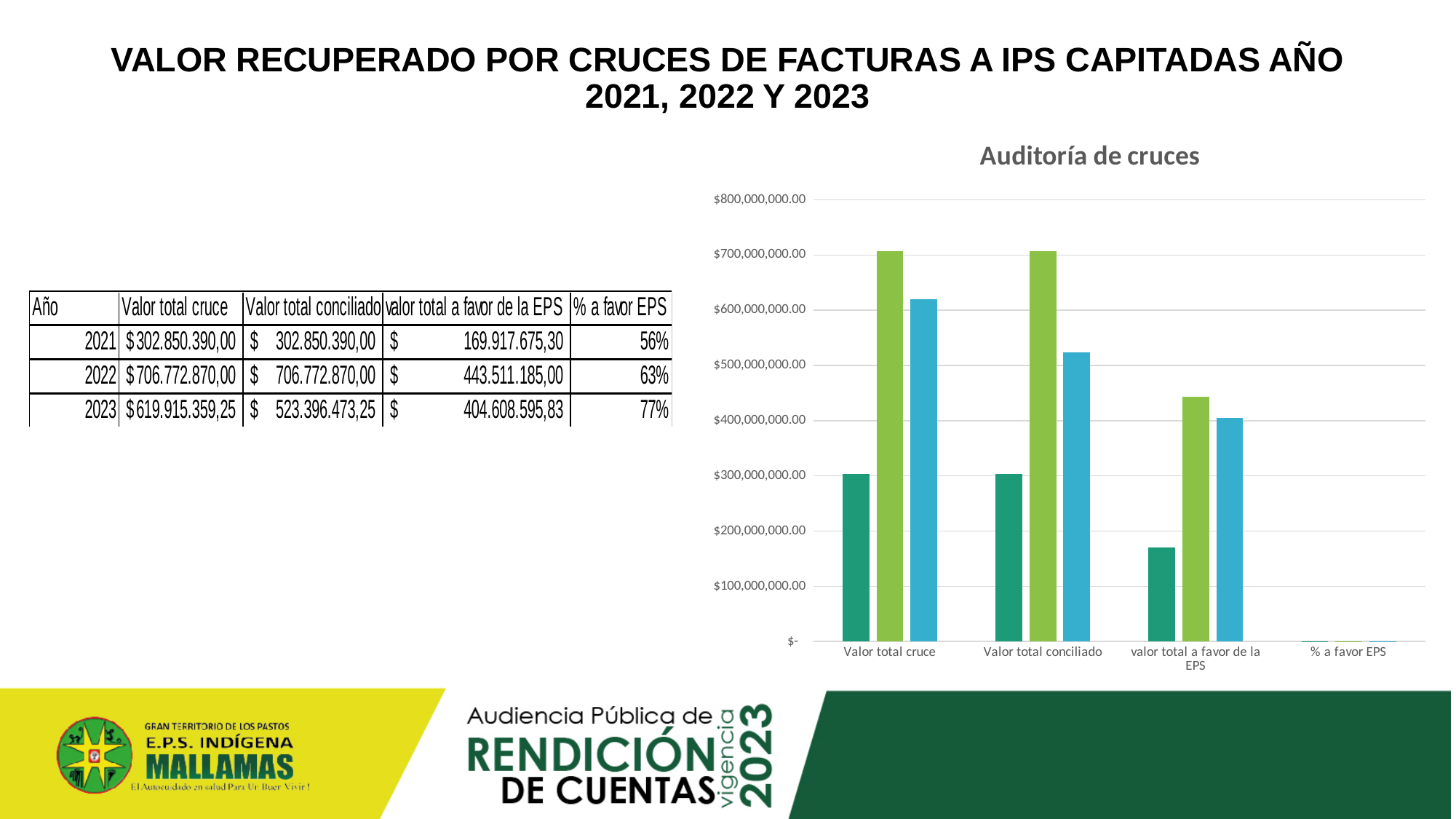
In the 'Auditoría de cruces' chart, is the light green bar for 'valor total a favor de la EPS' greater or less than $400,000,000.00? greater In the 'Auditoría de cruces' chart, which category has the lowest bars? % a favor EPS In the 'Auditoría de cruces' chart, is the light green bar for 'Valor total conciliado' greater or less than $600,000,000.00? greater What is the title of the chart on the right of the slide? Auditoría de cruces In the 'Auditoría de cruces' chart, is the dark green bar for 'valor total a favor de la EPS' greater or less than $200,000,000.00? less In the 'Auditoría de cruces' chart, among the dark green bars, which category has the lowest one? % a favor EPS In the 'Auditoría de cruces' chart, for 'Valor total conciliado', which is taller: the light green bar or the blue bar? the light green bar How many categories are shown on the x axis of the 'Auditoría de cruces' chart? 4 According to the table on the slide, what is the '% a favor EPS' for 2023? 77% What kind of chart is 'Auditoría de cruces'? bar chart